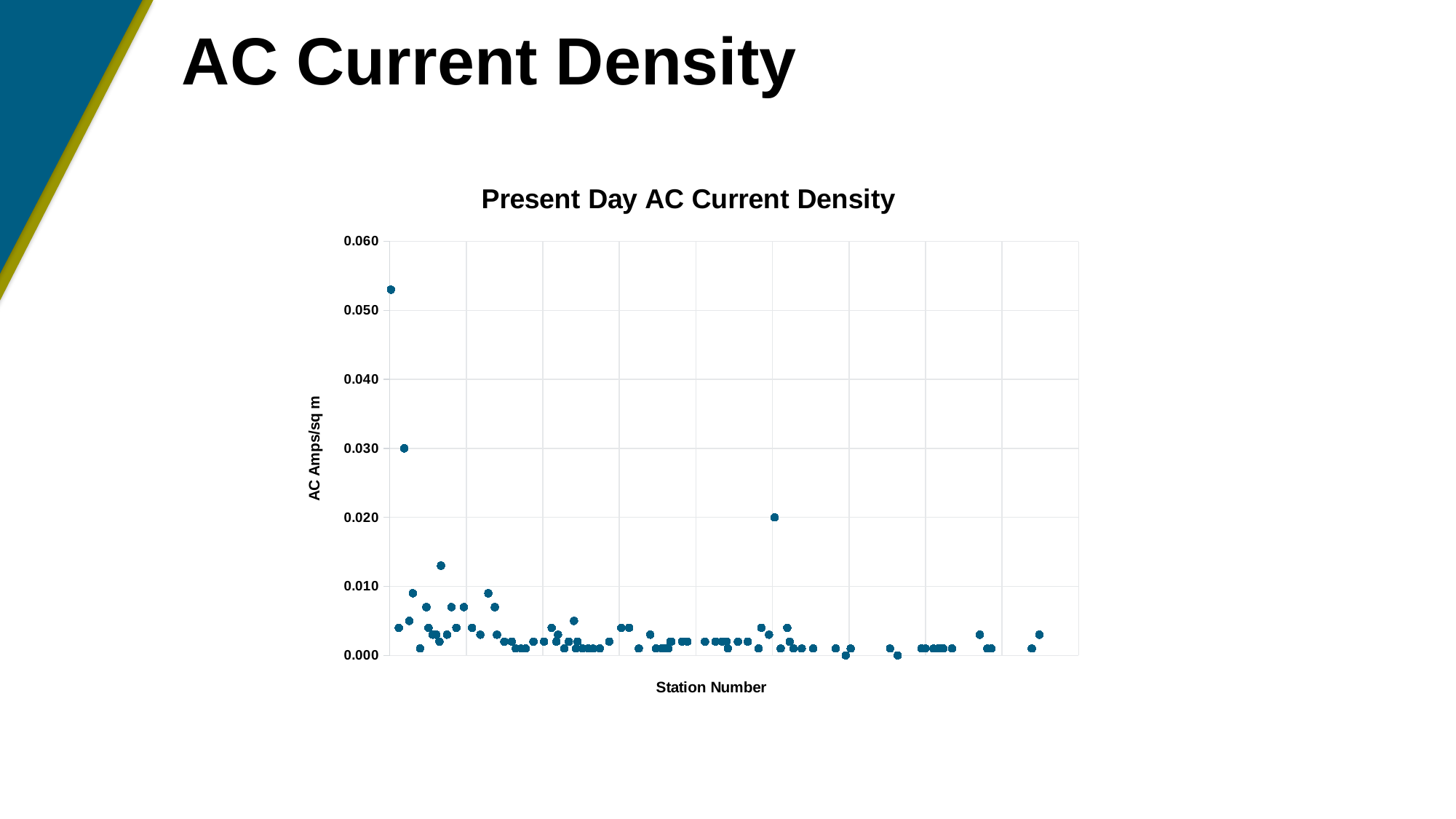
Is the second highest plotted value on the chart greater or less than 0.040? less What is the title of the chart? Present Day AC Current Density Is the highest point on the chart located at the left end or the right end of the x axis? left end What kind of chart is shown on the slide? Scatter chart What is the highest value shown on the vertical axis scale? 0.060 Is the highest plotted value on the chart greater or less than 0.060? less Do the plotted values generally rise or fall moving from left to right along the x axis? fall What is the label of the vertical axis of the chart? AC Amps/sq m Are the majority of the plotted points greater or less than 0.010 on the vertical axis? less